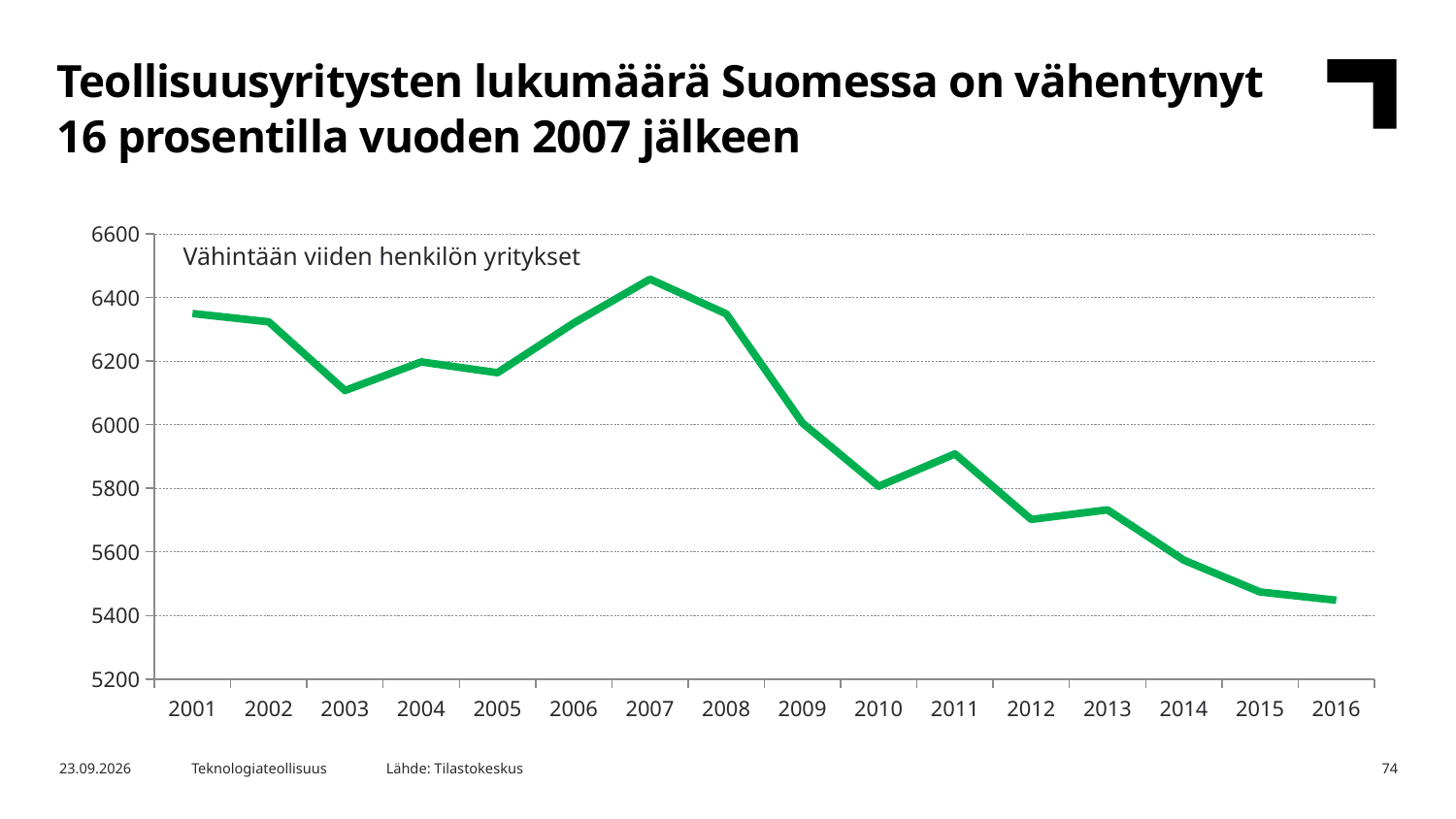
Which year has the higher value, 2003 or 2004? 2004 Is the value for 2011 greater or less than 6000? less Which year has the higher value, 2010 or 2011? 2011 Is the value for 2007 greater or less than 6400? greater Is the value for 2016 greater or less than 5600? less What text label appears inside the plot area of the chart? Vähintään viiden henkilön yritykset In which year does the line reach its highest value? 2007 What kind of chart is shown on the slide? Line chart How many years are plotted on the x axis of the chart? 16 In which year does the line reach its lowest value? 2016 Does the line generally rise or fall from 2007 to 2016? Fall